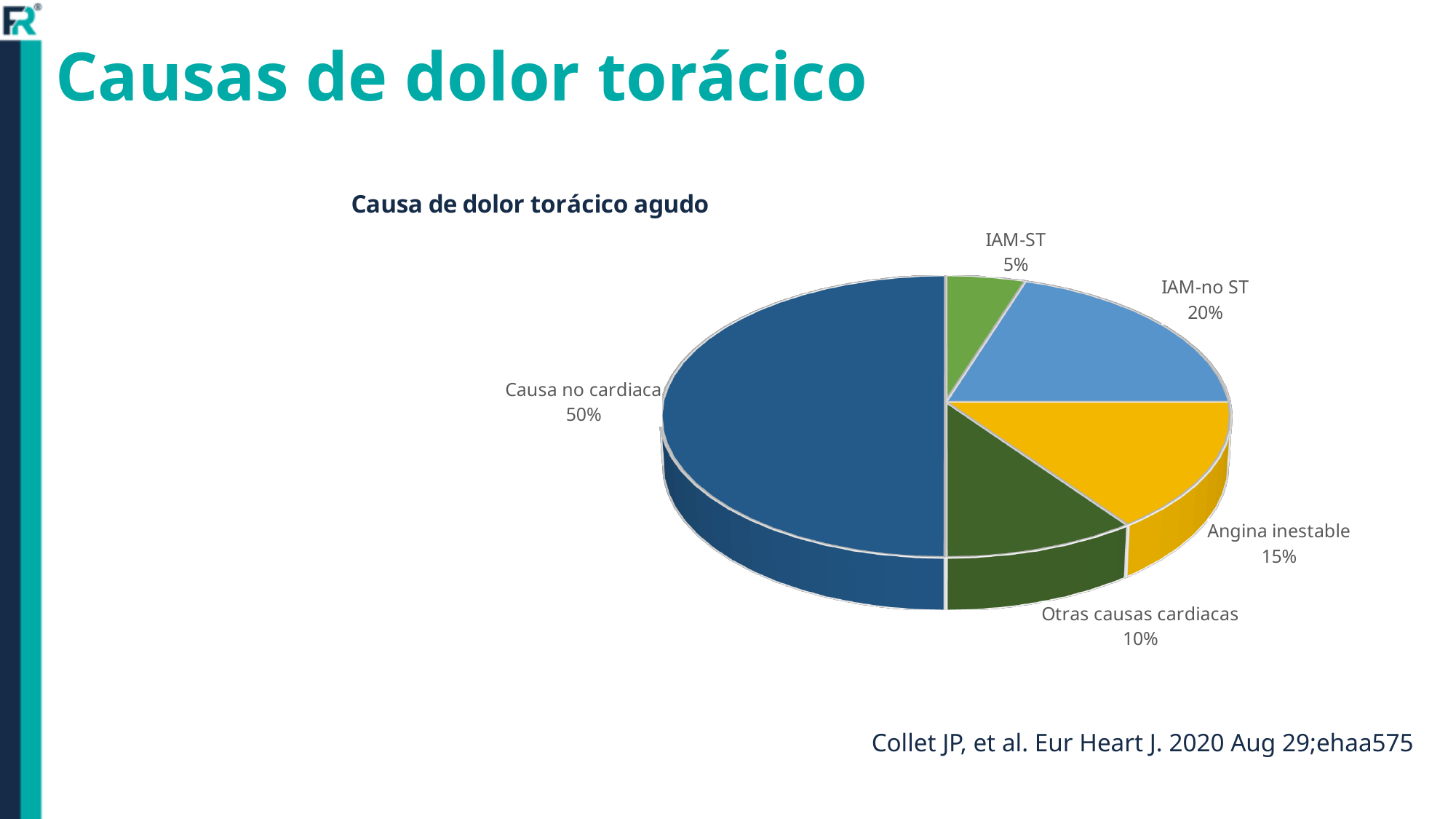
What percentage is shown for Otras causas cardiacas? 10% What type of chart is shown on the slide? Pie chart What percentage of the pie is Causa no cardiaca? 50% Which category has the smallest share of the pie? IAM-ST What is the difference in percentage points between IAM-no ST and Angina inestable? 5 Which is larger, Otras causas cardiacas or Angina inestable? Angina inestable What percentage is shown for Angina inestable? 15% What percentage is shown for IAM-no ST? 20% Which category has the largest share of the pie? Causa no cardiaca What is the title of the chart? Causa de dolor torácico agudo How many categories are shown in the pie chart? 5 What percentage is shown for IAM-ST? 5%